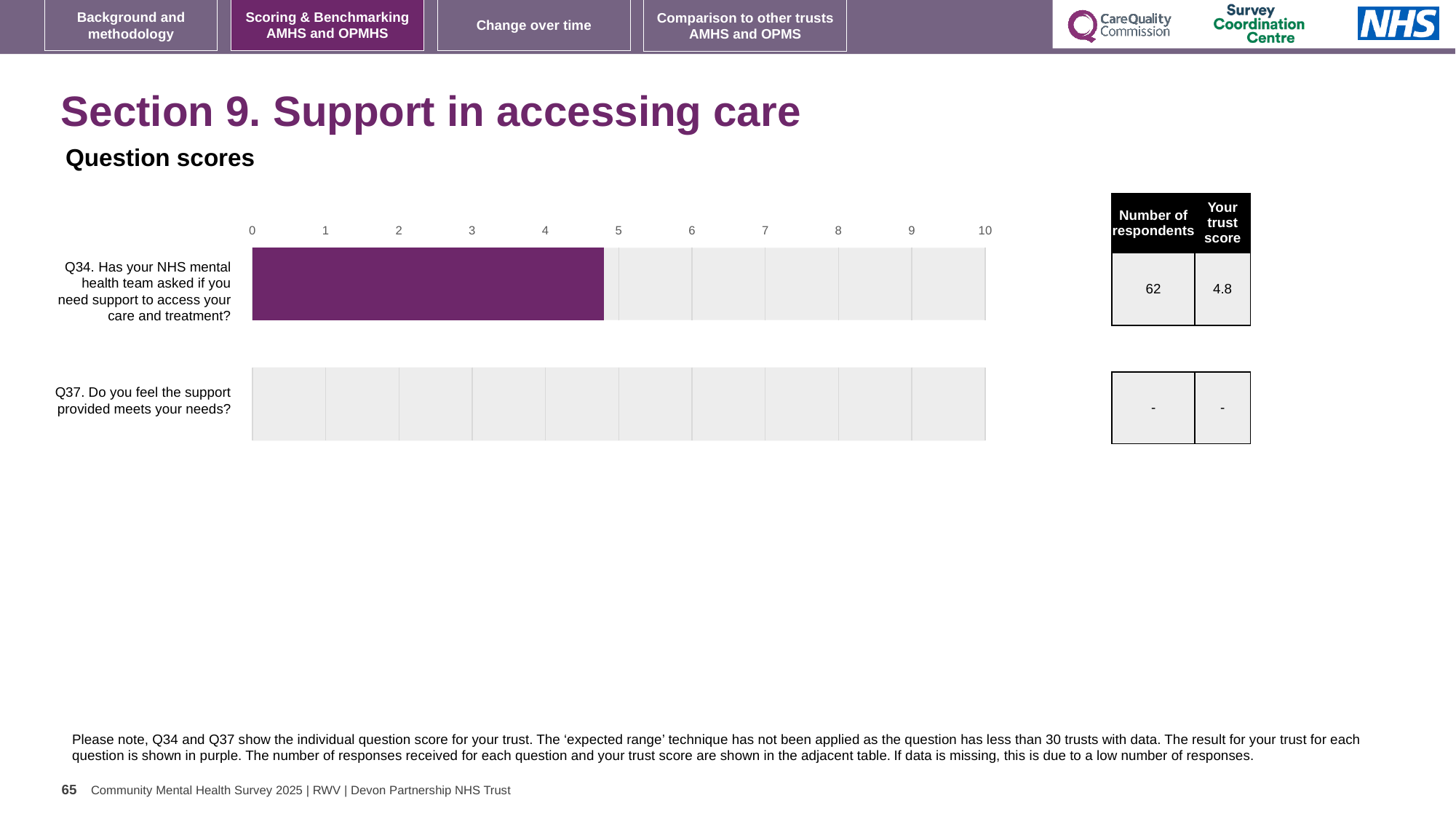
What kind of chart is shown on the slide? bar chart How many respondents answered Q34 according to the table? 62 Which question has no score plotted on the chart? Q37 How many questions are listed on the chart? 2 What is shown in the table for the number of respondents for Q37? - What is the trust score for Q34 shown in the adjacent table? 4.8 Which question has a bar plotted on the chart? Q34 Is the value for Q34 greater or less than 5? less Is the value for Q34 greater or less than 4? greater What is the highest value shown on the chart's axis? 10